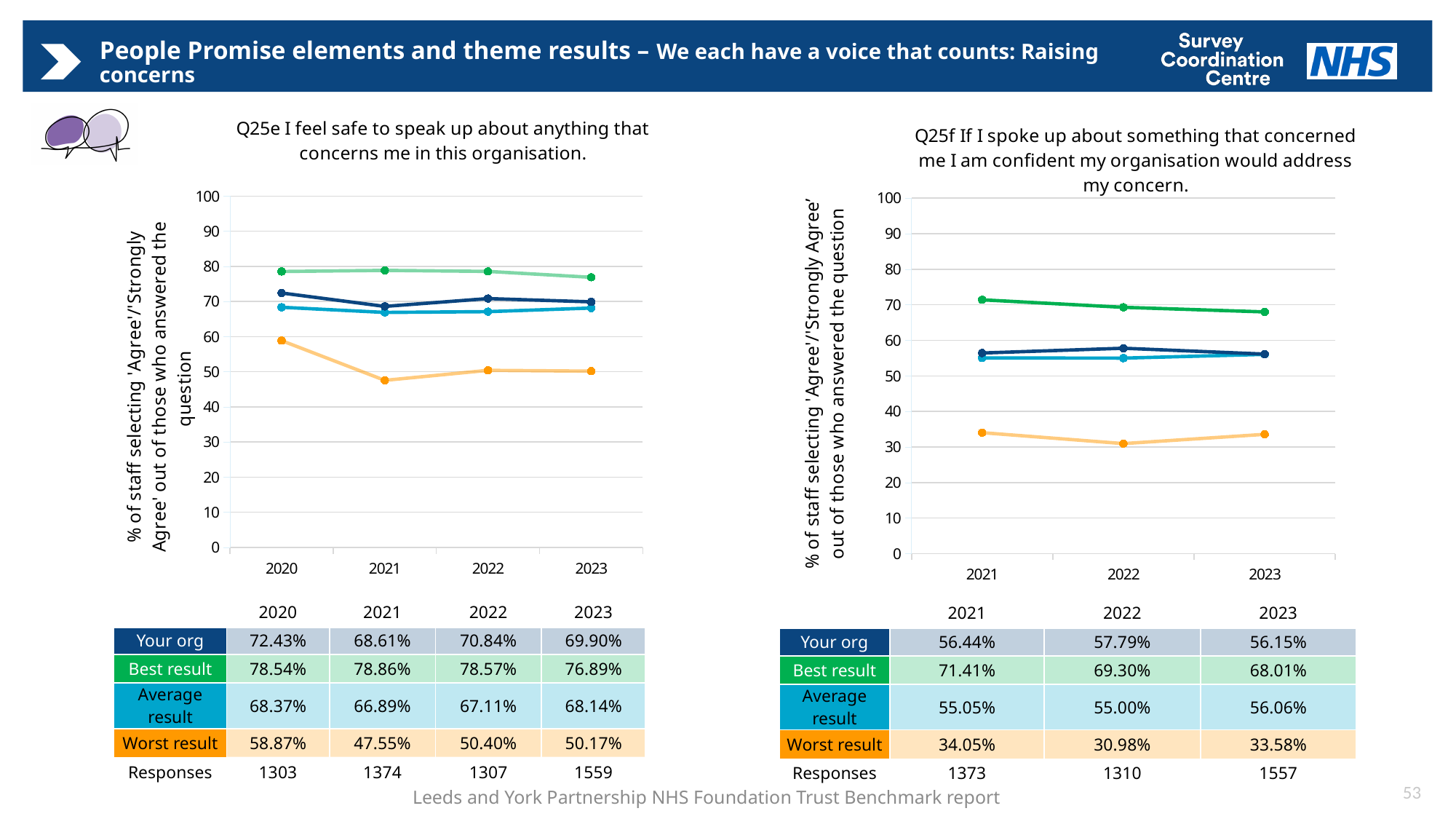
In the Q25f chart, which year had the highest 'Your org' value? 2022 In the Q25e chart, which year had the lowest 'Worst result' value? 2021 What kind of chart is used for Q25e? Line chart How many series are plotted in the Q25f chart? 4 In the Q25f chart, what is the difference between the 'Your org' and 'Average result' values in 2022? 2.79% In the Q25e chart, what is the difference between the 'Best result' and 'Your org' values in 2023? 6.99% How many years are plotted on the x axis of the Q25e chart? 4 In the Q25f chart, what was the 'Best result' value in 2021? 71.41% In the Q25f chart, is the 'Worst result' value for 2022 greater or less than 40? less In the Q25e chart, which is larger in 2021: 'Your org' or 'Average result'? Your org In the Q25f chart, does the 'Best result' line rise or fall from 2021 to 2023? Fall In the Q25e chart, what was the 'Your org' value in 2022? 70.84%